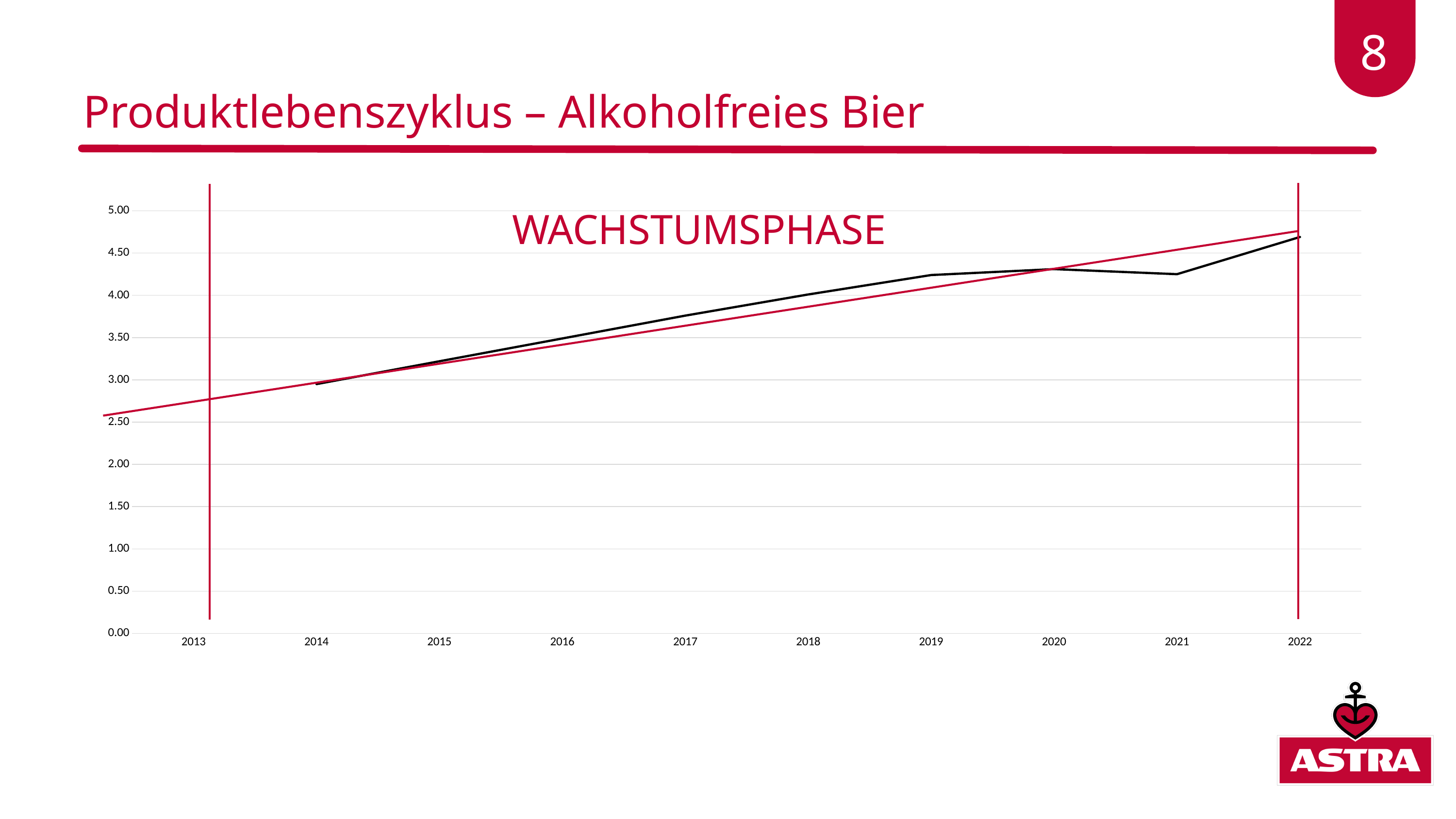
Is the value of the black line for 2021 greater or less than 4.50? less Is the value of the black line for 2016 greater or less than 3.00? greater What kind of chart is shown on the slide? line chart Is the value of the black line for 2019 greater or less than 4.00? greater In which year does the black line reach its highest value? 2022 Does the black line generally rise or fall from 2014 to 2022? rise In which year does the black line have its lowest value? 2014 How many year labels are shown on the x axis? 10 What phase label is written in red above the lines in the chart? WACHSTUMSPHASE Which year has the larger value on the black line, 2016 or 2019? 2019